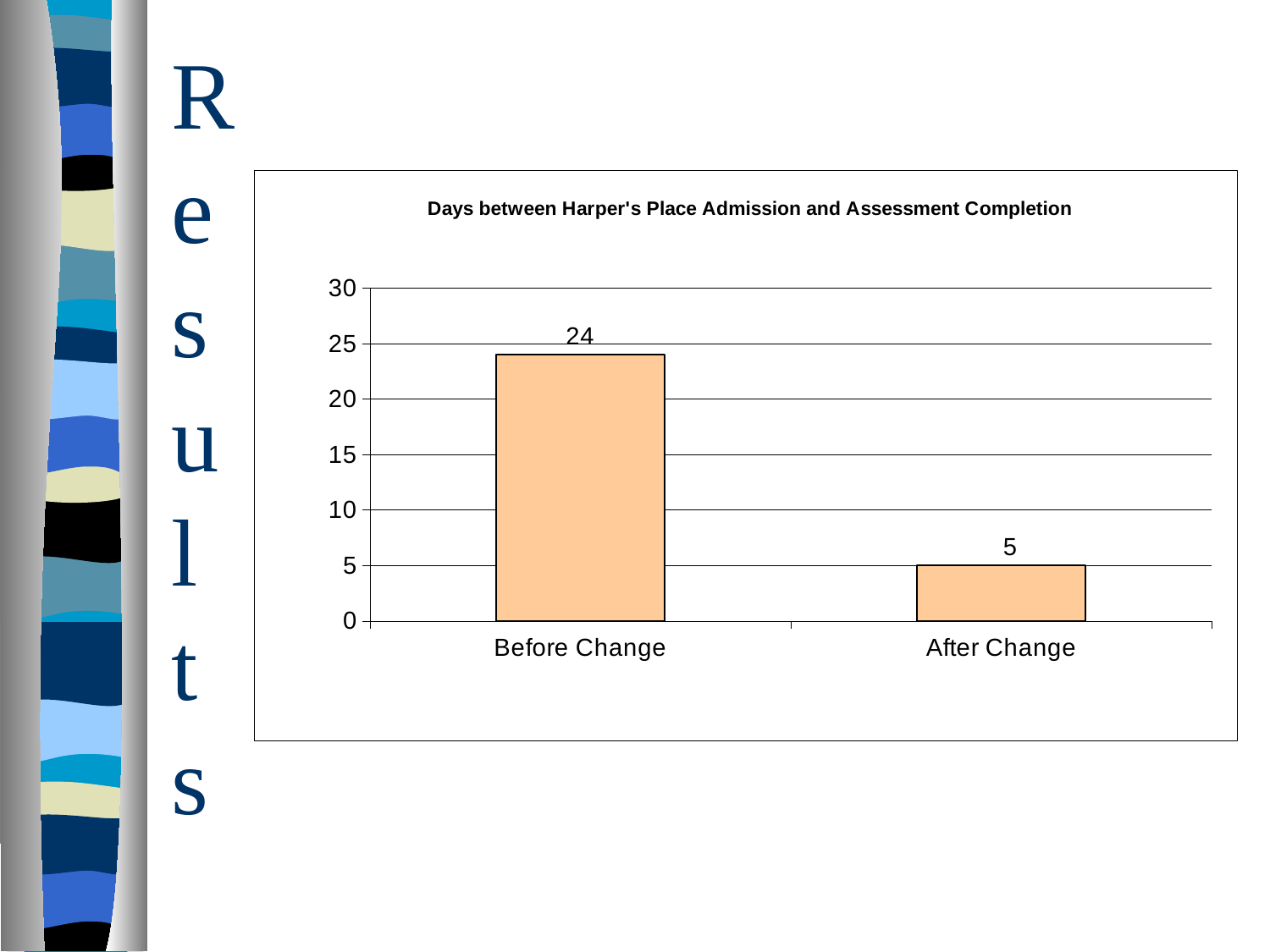
Which is larger, the value for Before Change or the value for After Change? Before Change What kind of chart is shown on the slide? bar chart Which category has the highest value? Before Change How many categories are shown on the x axis? 2 Which category has the lowest value? After Change What is the title of the chart? Days between Harper's Place Admission and Assessment Completion Is the value for After Change greater or less than 10? less What is the value for Before Change? 24 Do the values rise or fall from Before Change to After Change? fall What is the difference between the Before Change and After Change values? 19 Is the value for Before Change greater or less than 20? greater What is the value for After Change? 5